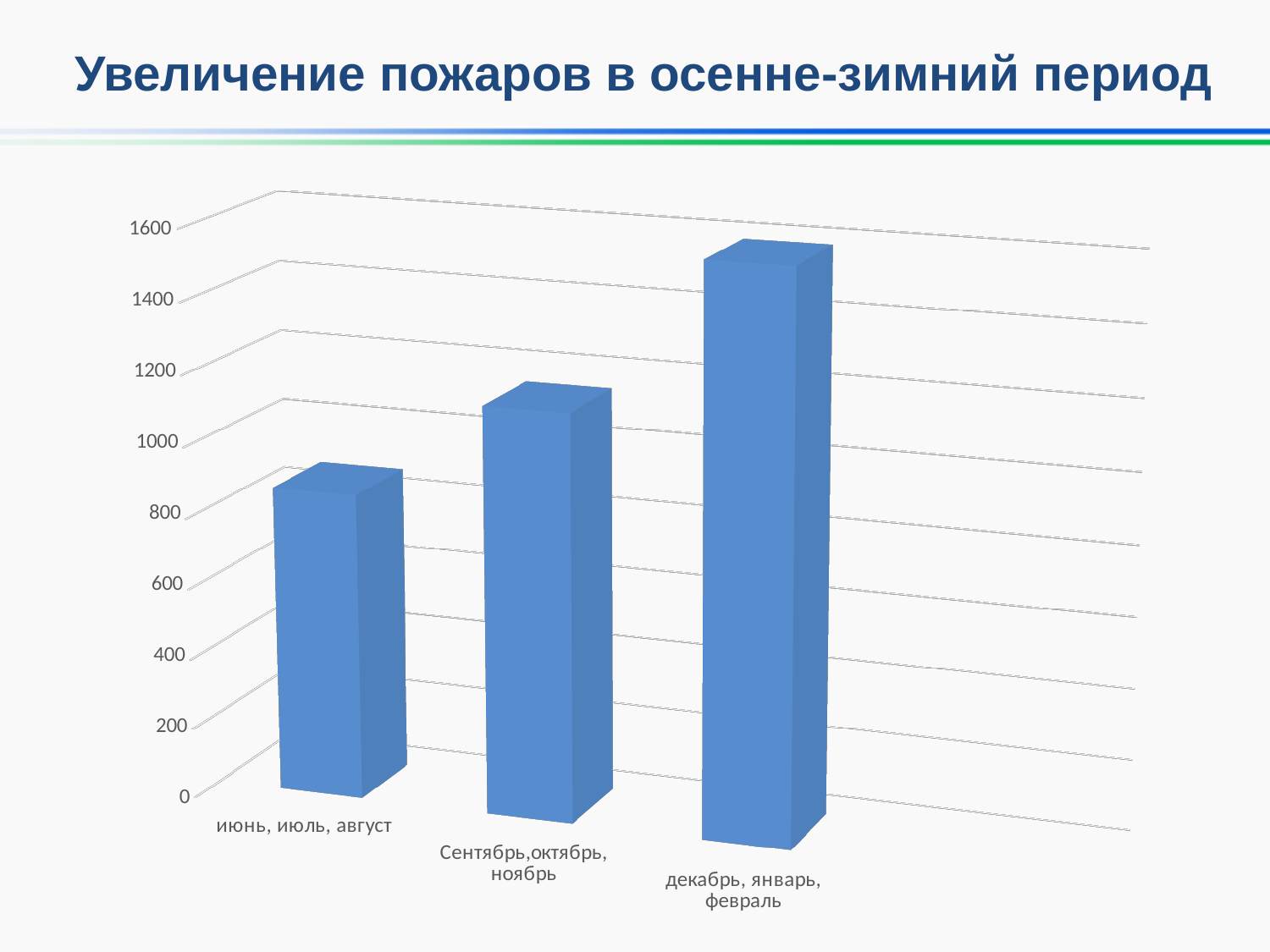
How many categories are plotted on the chart? 3 What kind of chart is shown on the slide? bar chart Which is larger, the value for "Сентябрь,октябрь, ноябрь" or the value for "июнь, июль, август"? Сентябрь,октябрь, ноябрь Do the values rise or fall from left to right along the x axis? rise What is the title of the slide above the chart? Увеличение пожаров в осенне-зимний период Is the value for "июнь, июль, август" greater or less than 1000? less Is the value for "Сентябрь,октябрь, ноябрь" greater or less than 800? greater Which is larger, the value for "июнь, июль, август" or the value for "декабрь, январь, февраль"? декабрь, январь, февраль Is the value for "декабрь, январь, февраль" greater or less than 1200? greater Which category has the lowest bar? июнь, июль, август Which category has the highest bar? декабрь, январь, февраль